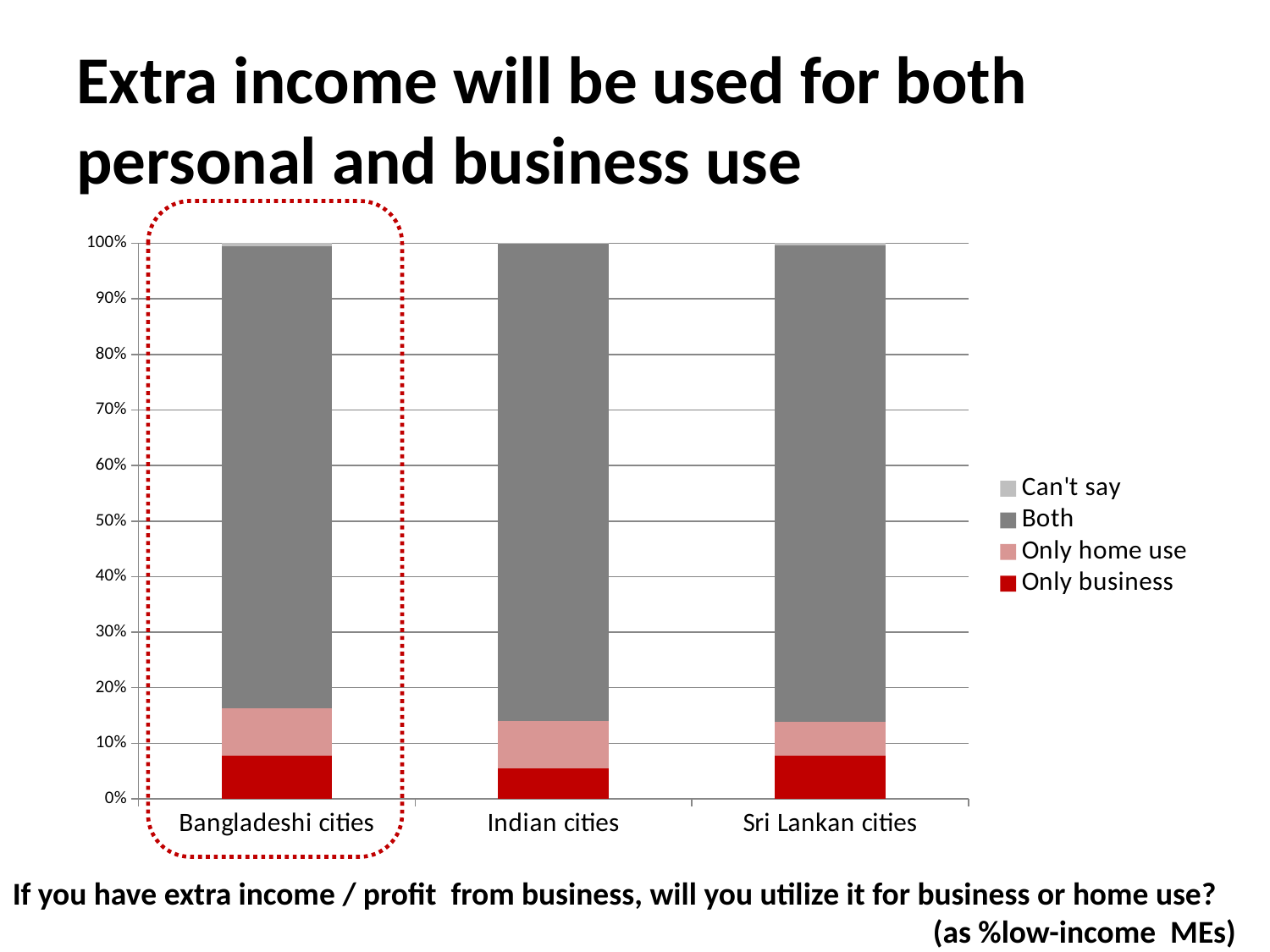
Is the combined 'Only business' and 'Only home use' share for Sri Lankan cities greater or less than 20%? less Which is larger, the 'Only business' value for Bangladeshi cities or for Indian cities? Bangladeshi cities Which category is highlighted with a red dotted outline? Bangladeshi cities How many series does the legend list? 4 How many city groups (categories) are shown on the x axis? 3 Is the 'Both' share for Bangladeshi cities greater or less than 80%? greater What is the title of the slide? Extra income will be used for both personal and business use Which category has the lowest value for the 'Only business' series? Indian cities Is the 'Only business' value for Bangladeshi cities greater or less than 10%? less Which series occupies the largest portion of every bar? Both What kind of chart is shown on the slide? Stacked bar chart